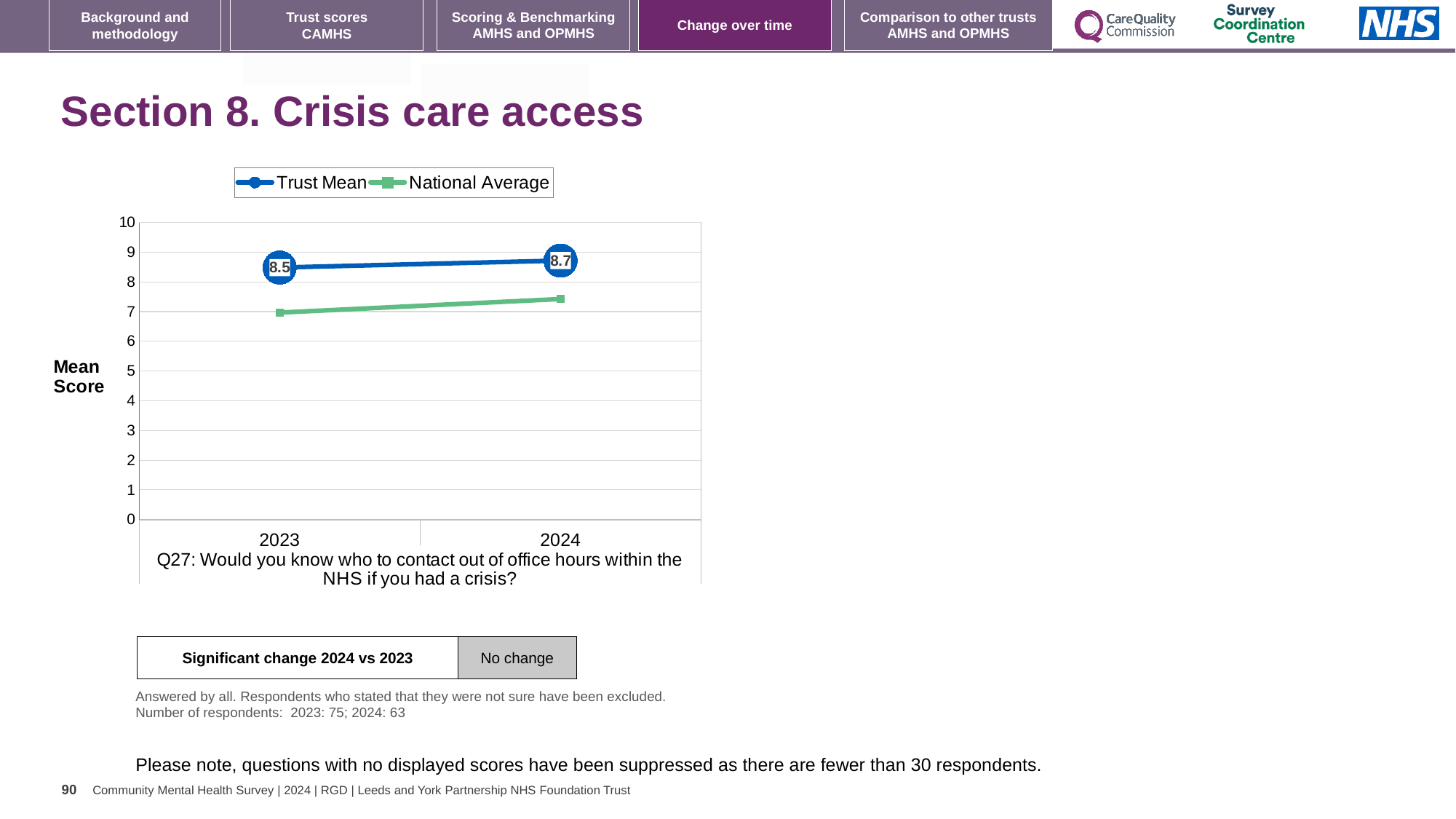
In which year is the Trust Mean score lower? 2023 What is the label on the y axis of the chart? Mean Score What is the Trust Mean score for 2023? 8.5 What is the Trust Mean score for 2024? 8.7 Which is larger in 2024, the Trust Mean or the National Average? Trust Mean How many years are shown on the x axis? 2 What is the difference between the Trust Mean scores for 2024 and 2023? 0.2 What kind of chart is shown on the slide? line chart In which year is the Trust Mean score higher? 2024 Is the National Average value for 2024 greater or less than 8? less Does the Trust Mean rise or fall from 2023 to 2024? rise How many series does the legend list? 2